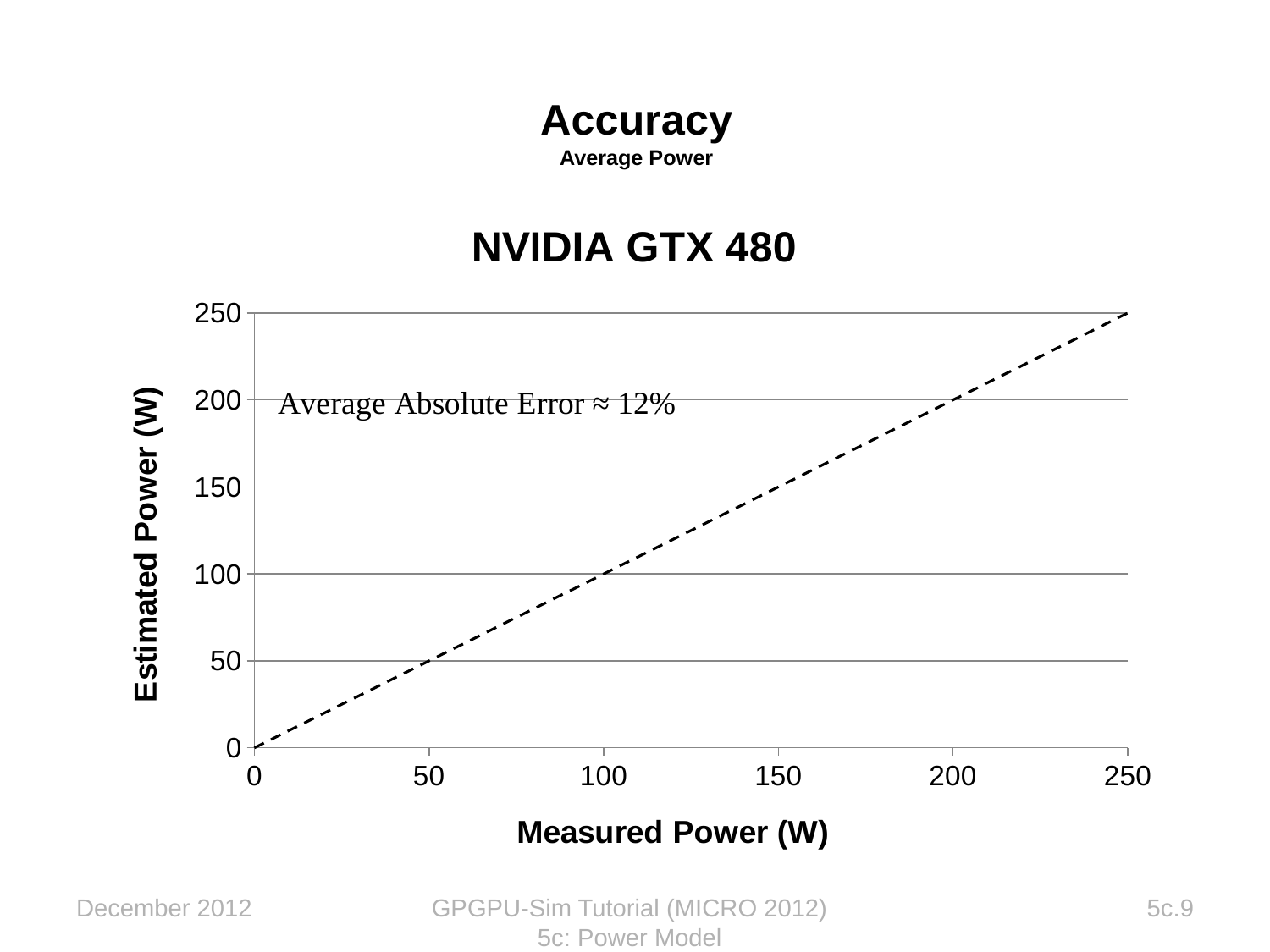
What is the Estimated Power value of the dashed line where Measured Power is 250? 250 Which is larger: the Estimated Power of the dashed line at Measured Power 150 or at Measured Power 100? at Measured Power 150 Does the dashed line rise or fall as Measured Power increases along the x axis? rise What is the Estimated Power value of the dashed line where Measured Power is 0? 0 What is the label of the x axis? Measured Power (W) What is the title of the chart? NVIDIA GTX 480 Is the Estimated Power of the dashed line at Measured Power 200 greater or less than 150? greater What is the highest value shown on the y axis? 250 What kind of chart is shown on the slide? line chart Is the Estimated Power of the dashed line at Measured Power 50 greater or less than 100? less